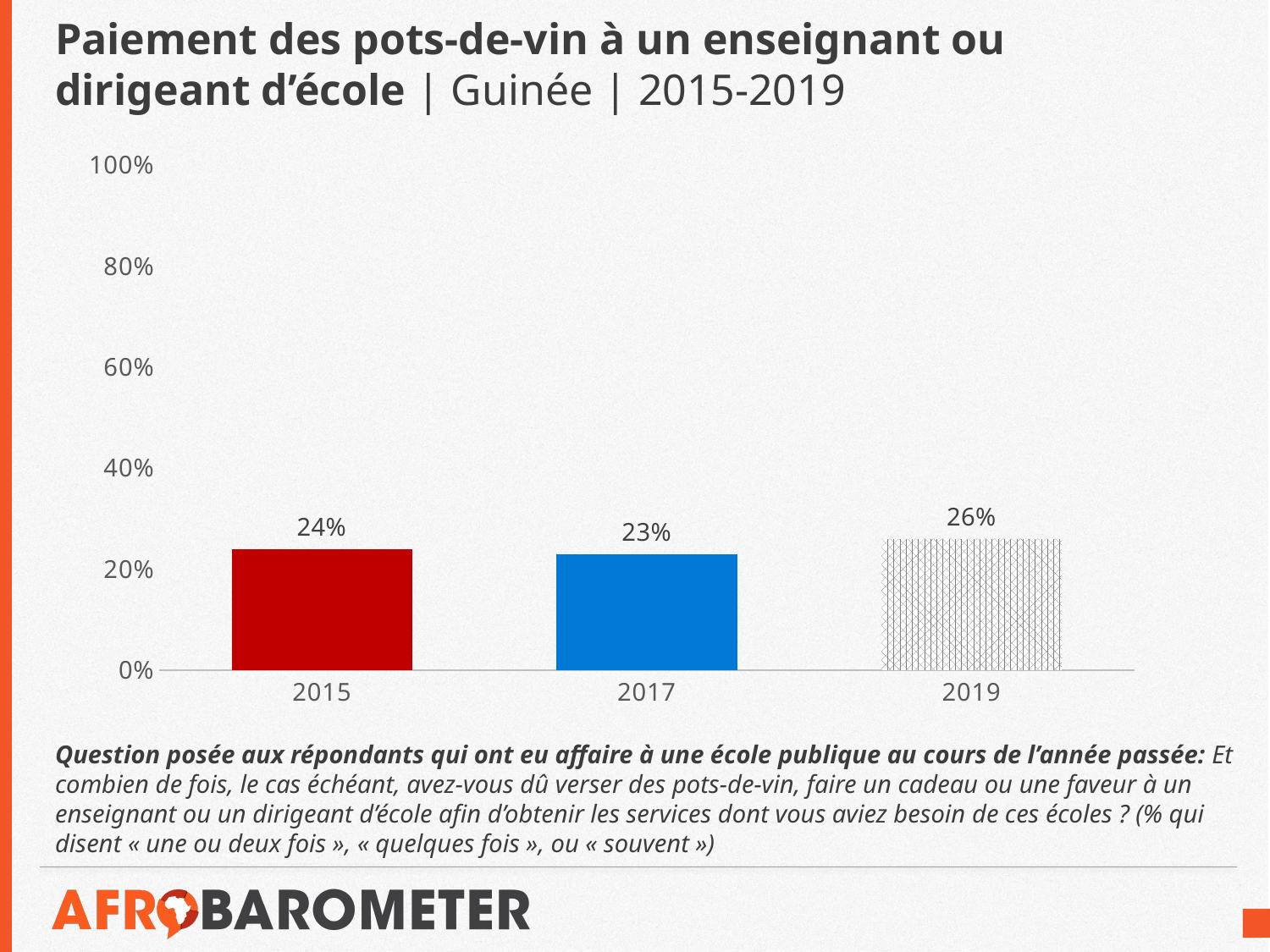
What is the value for 2017? 23% Which country does the chart title say the data is for? Guinée What is the difference between the values for 2019 and 2017? 3 percentage points Is the value for 2019 greater or less than 40%? less What is the difference between the values for 2015 and 2017? 1 percentage point Which year has the lowest value? 2017 What is the value for 2019? 26% How many years are shown on the x axis? 3 Which is larger, the value for 2015 or the value for 2019? 2019 Which year has the highest value? 2019 What is the value for 2015? 24% What kind of chart is shown on the slide? bar chart